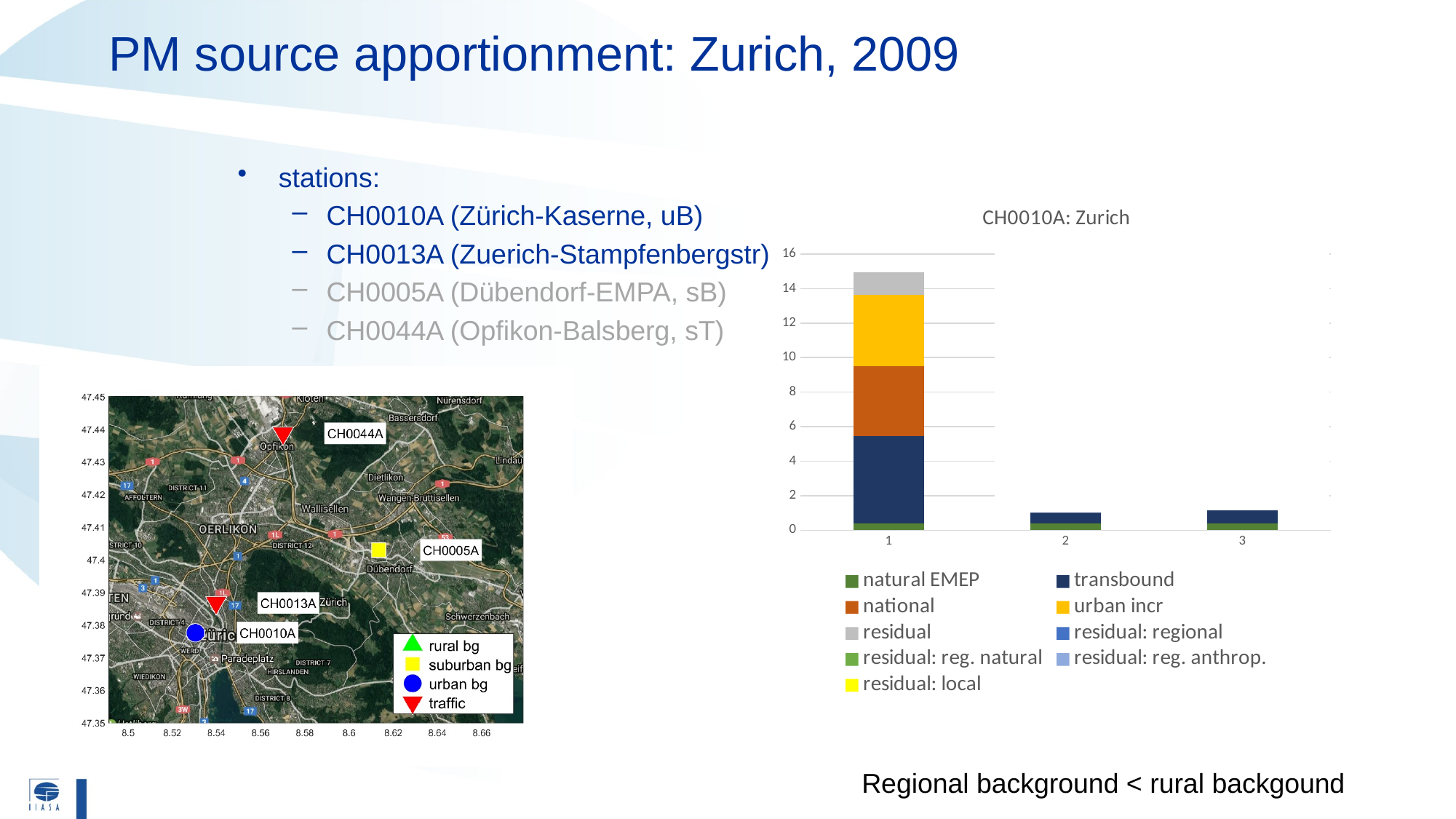
Is the total height of the bar for category 3 greater or less than 2? less What kind of chart is shown on the slide? stacked bar chart In the bar for category 1, which segment is larger: transbound or residual? transbound Which is larger, the total bar for category 1 or the total bar for category 2? category 1 What is the title of the chart? CH0010A: Zurich How many series does the chart's legend list? 9 Is the total height of the bar for category 2 greater or less than 2? less How many bars (categories) are plotted on the x axis of the chart? 3 Which category has the tallest stacked bar? 1 Which legend entry is shown in dark blue? transbound Do the total bar heights rise or fall from category 1 to category 2? fall Is the total height of the bar for category 1 greater or less than 14? greater